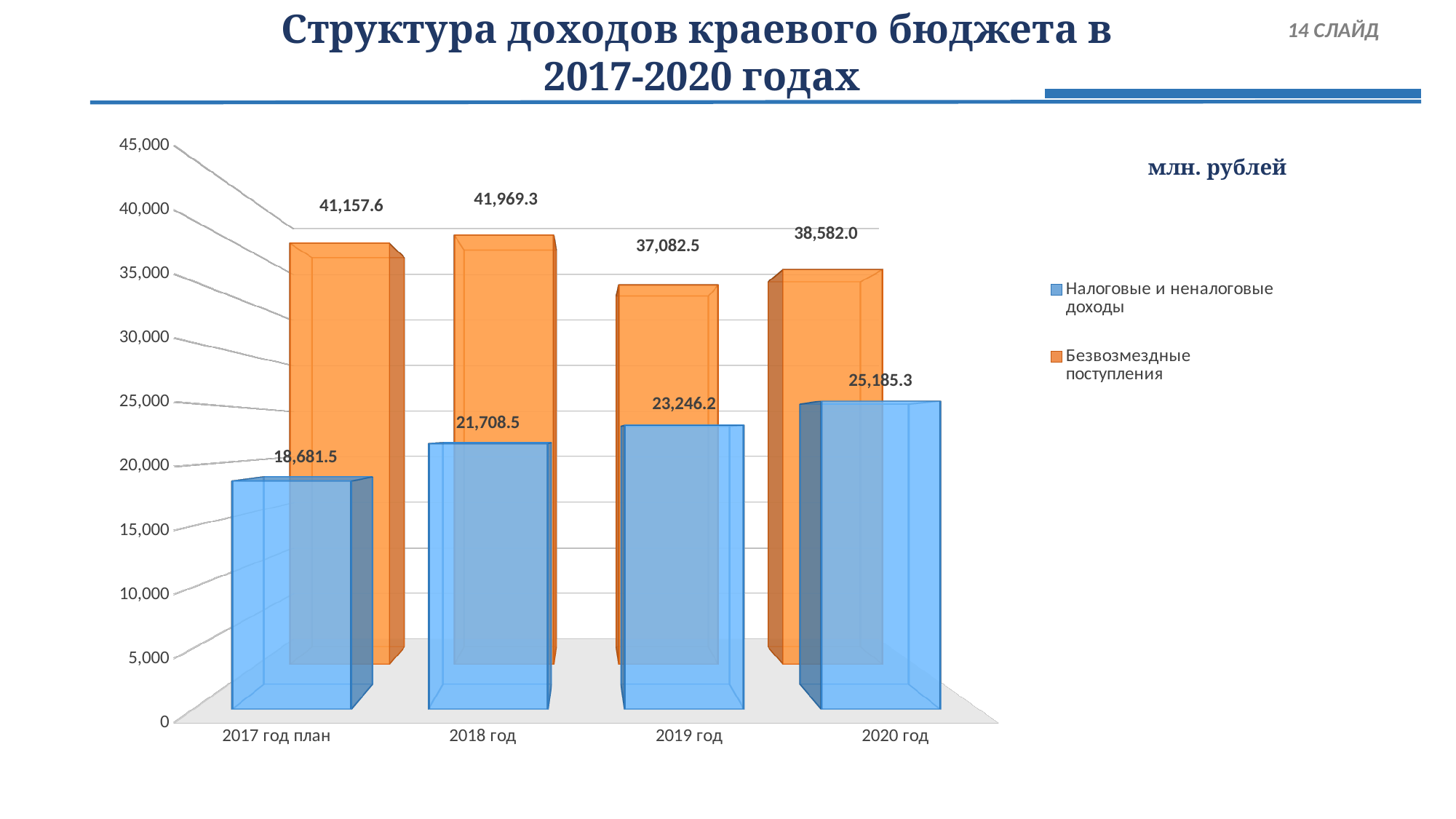
What is the difference between Безвозмездные поступления and Налоговые и неналоговые доходы in 2017 год план? 22,476.1 In which year is Безвозмездные поступления highest? 2018 год Do the values of Налоговые и неналоговые доходы rise or fall from 2017 год план to 2020 год? Rise How many year categories are shown on the x axis? 4 What kind of chart is shown on the slide? Bar chart Which is larger in 2019 год: Налоговые и неналоговые доходы or Безвозмездные поступления? Безвозмездные поступления By how much did Налоговые и неналоговые доходы grow from 2017 год план to 2020 год? 6,503.8 What is the value of Безвозмездные поступления for 2020 год? 38,582.0 How many series does the legend list? 2 In which category is Налоговые и неналоговые доходы lowest? 2017 год план What is the value of Безвозмездные поступления for 2017 год план? 41,157.6 What is the value of Налоговые и неналоговые доходы for 2019 год? 23,246.2